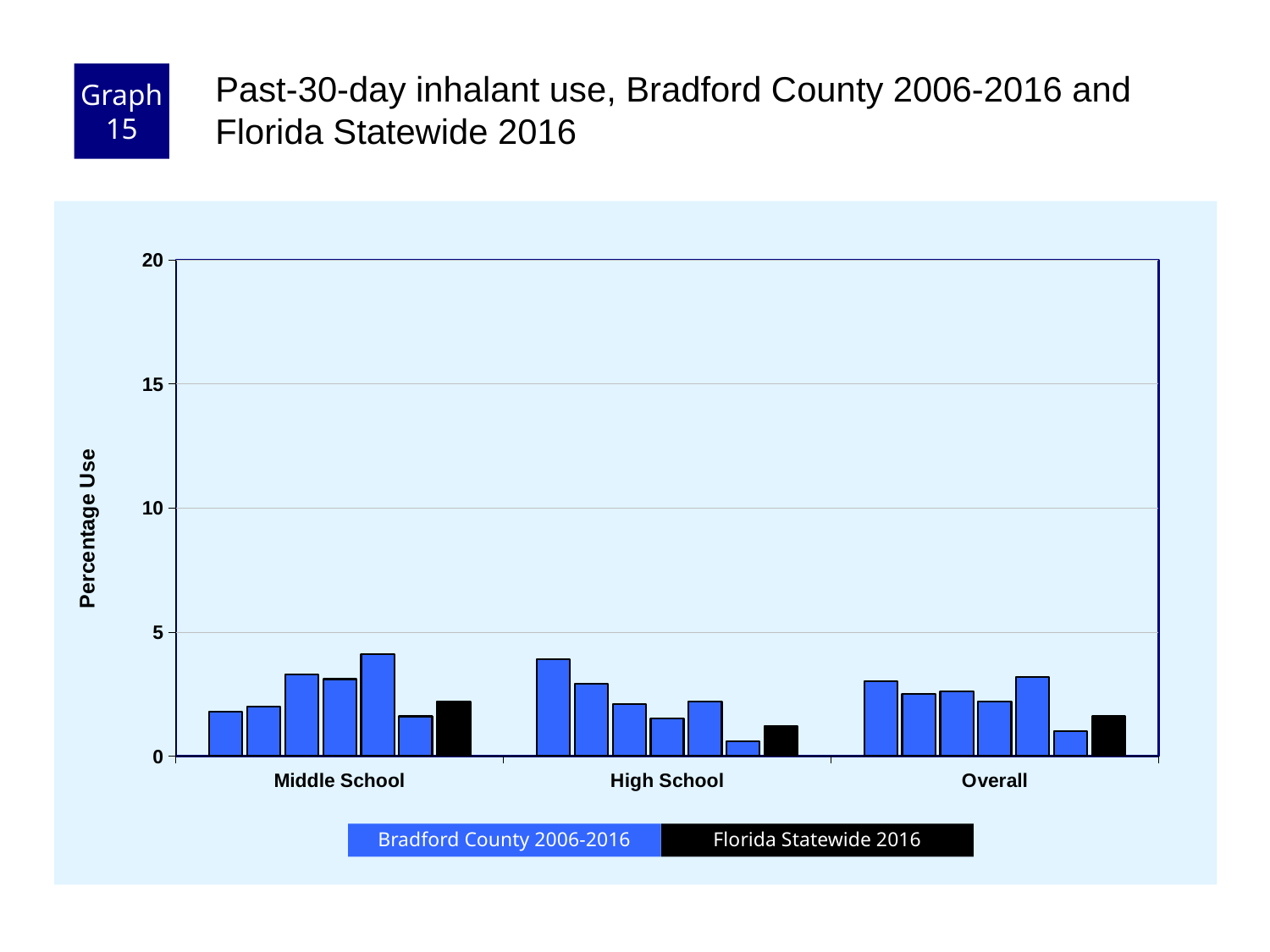
Is the Florida Statewide 2016 value for Middle School greater or less than 5? less Is the Florida Statewide 2016 value for High School greater or less than 5? less Which colour represents Florida Statewide 2016 in the legend? black What kind of chart is shown on the slide? bar chart How many categories are shown along the x axis? 3 Is the tallest bar in the Middle School group greater or less than 5? less Which category has the larger Florida Statewide 2016 value, Middle School or High School? Middle School Which category has the smaller Florida Statewide 2016 value, High School or Overall? High School How many bars are plotted in the Middle School group? 7 How many series does the legend list? 2 What is the label on the y axis? Percentage Use